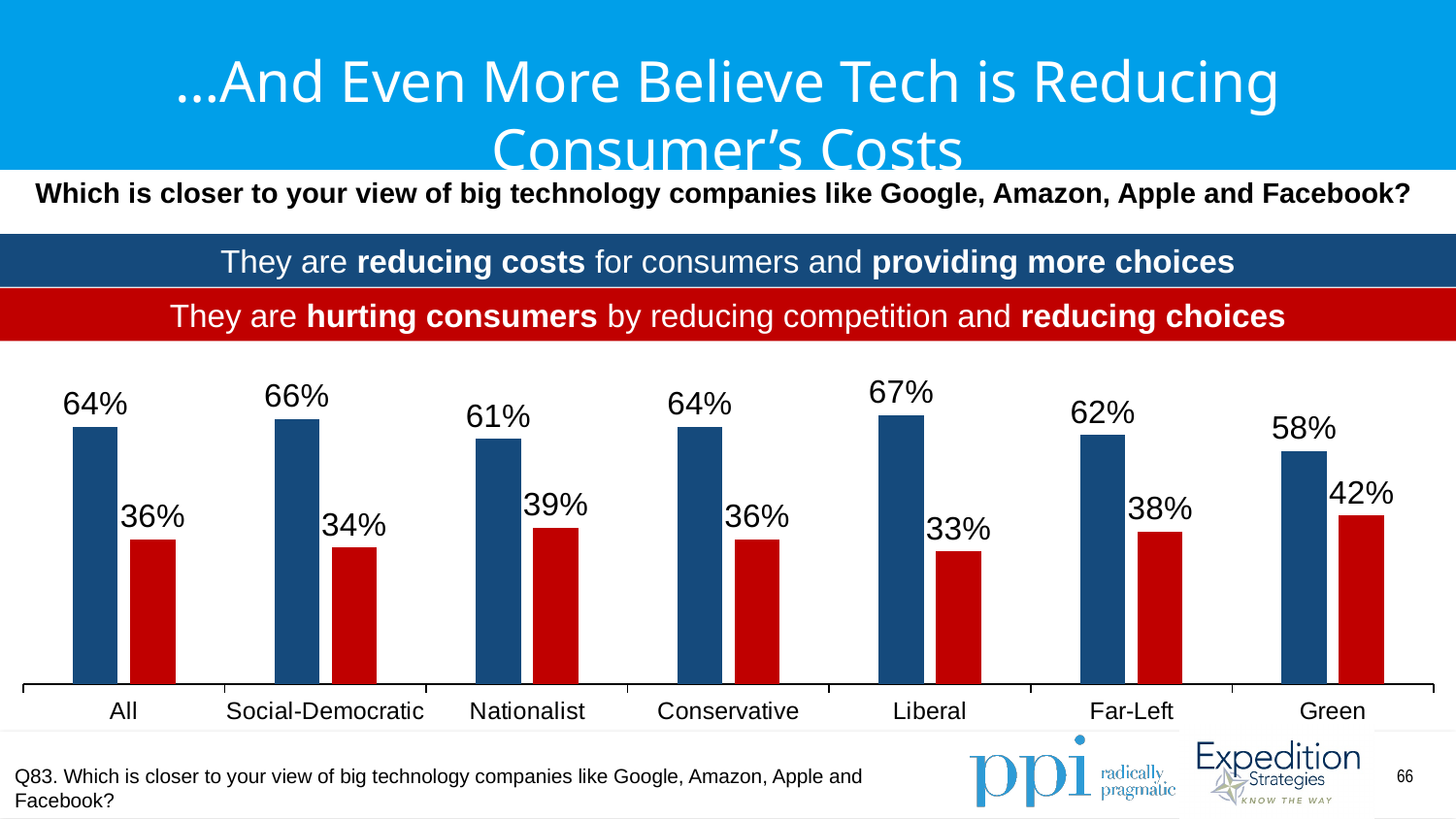
What is the difference between the 'reducing costs' and 'hurting consumers' percentages for the All group? 28 percentage points Is the 'hurting consumers' percentage higher for Far-Left or for Social-Democratic respondents? Far-Left Which group has the lowest share saying tech companies are hurting consumers? Liberal What type of chart is shown on the slide? Bar chart Which group has the highest share saying tech companies are reducing costs and providing more choices? Liberal What percentage of Green respondents say big tech companies are hurting consumers by reducing competition and reducing choices? 42% What is the value of the blue bar for the Nationalist group? 61% Which colour represents the response 'They are hurting consumers by reducing competition and reducing choices'? Red How many groups are shown along the x axis? 7 What percentage of Liberal respondents say big tech companies are reducing costs for consumers and providing more choices? 67% How many response options (series) are plotted for each group? 2 Which group has the lowest share saying tech companies are reducing costs and providing more choices? Green